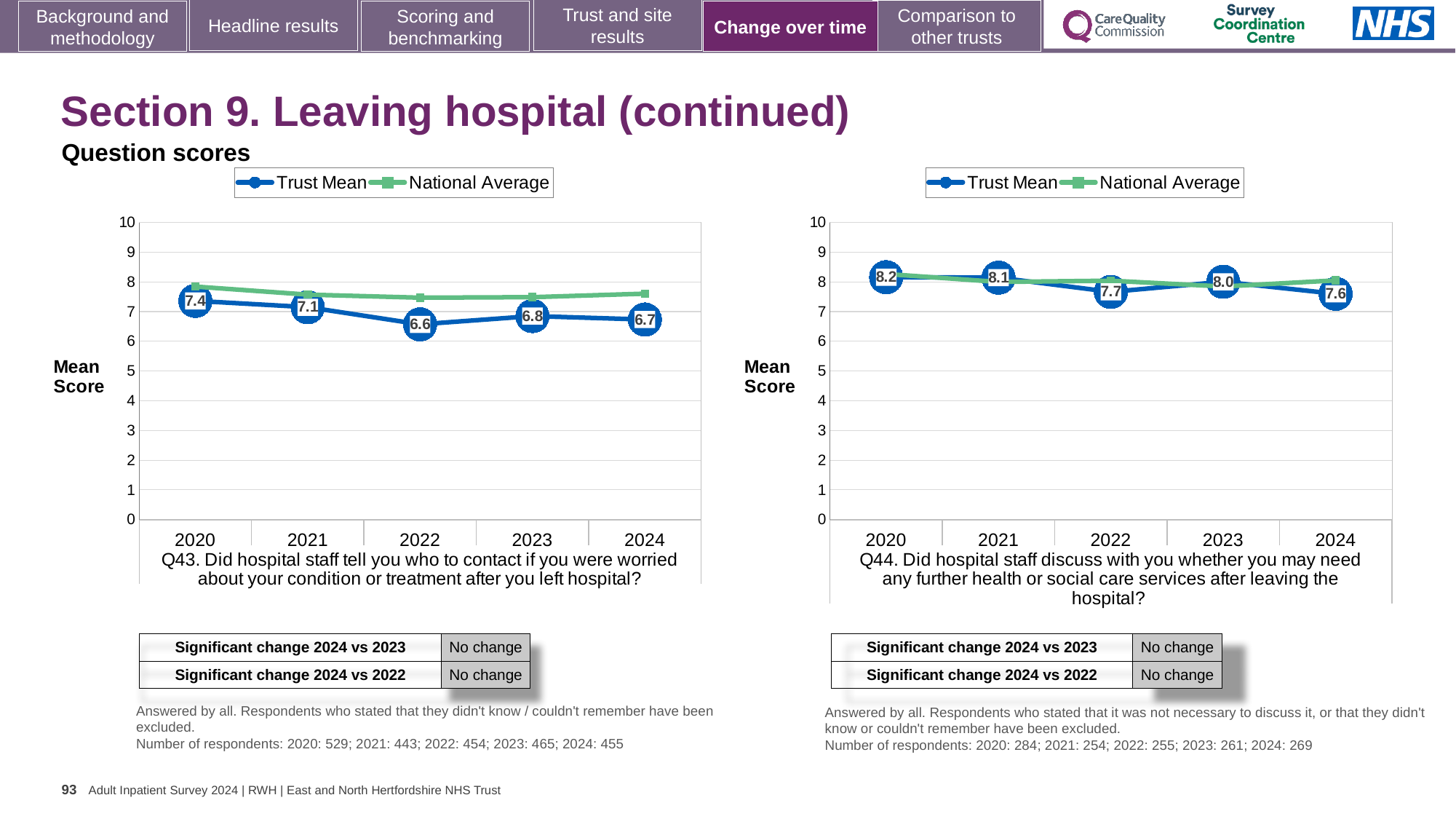
In the Q43 chart (left), what is the Trust Mean score for 2022? 6.6 How many years are plotted on the x axis of the Q43 chart (left)? 5 In the Q43 chart (left), does the Trust Mean score rise or fall from 2020 to 2022? Fall In the Q43 chart (left), is the National Average value for 2020 greater or less than 7? greater In the Q44 chart (right), what is the difference between the Trust Mean scores for 2020 and 2024? 0.6 In the Q44 chart (right), which year has the lowest Trust Mean score? 2024 How many series does the legend of the Q44 chart (right) list? 2 In the Q43 chart (left), which year has the highest Trust Mean score? 2020 In the Q44 chart (right), which is larger: the Trust Mean score for 2021 or for 2022? 2021 What kind of chart is the Q43 chart (left)? Line chart In the Q44 chart (right), what is the Trust Mean score for 2024? 7.6 In the Q43 chart (left), what is the difference between the Trust Mean scores for 2020 and 2022? 0.8